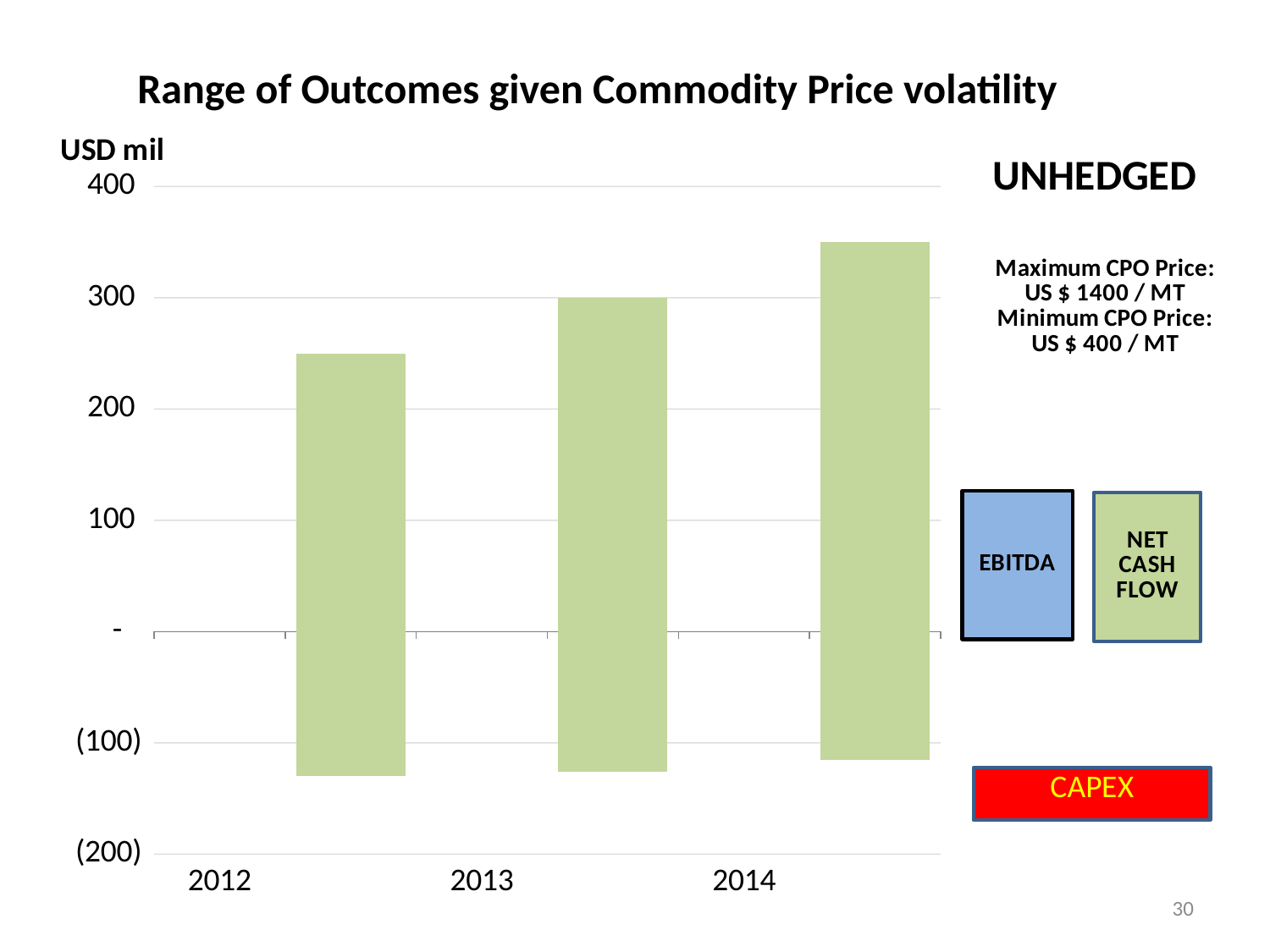
Is the lower end of the bar for 2013 greater or less than (100)? less What unit is shown for the vertical axis of the chart? USD mil How many years are shown on the x axis of the chart? 3 Is the upper end of the bar for 2014 greater or less than 300? greater Is the upper end of the bar for 2012 greater or less than 200? greater What kind of chart is shown on the slide? bar chart What is the title of the chart? Range of Outcomes given Commodity Price volatility Do the upper ends of the bars rise or fall from 2012 to 2014? rise Which year has the lowest upper end of its bar? 2012 Which year has the highest upper end of its bar? 2014